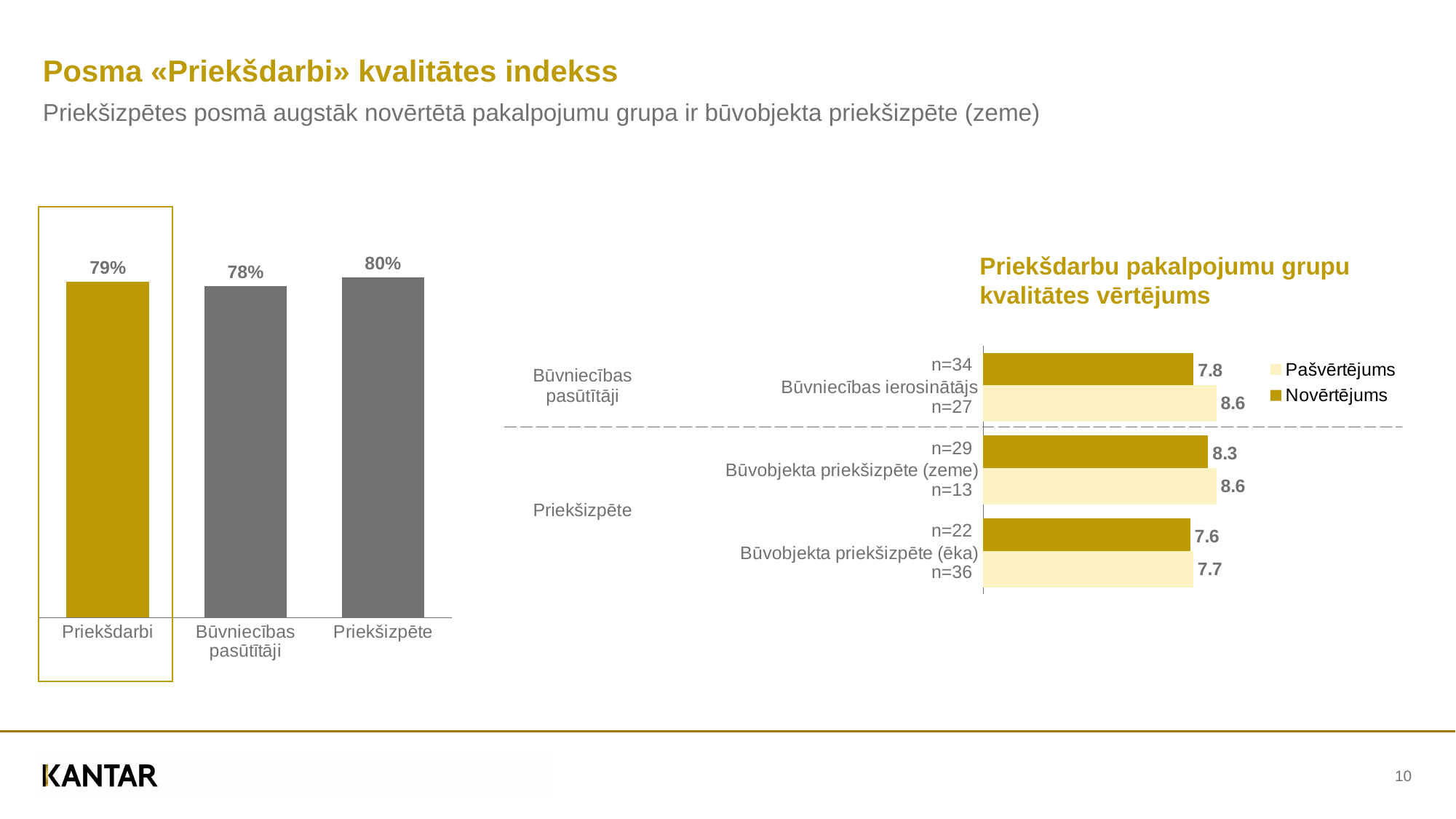
In the chart titled 'Priekšdarbu pakalpojumu grupu kvalitātes vērtējums', which is larger for Būvobjekta priekšizpēte (ēka): Pašvērtējums or Novērtējums? Pašvērtējums In the chart titled 'Priekšdarbu pakalpojumu grupu kvalitātes vērtējums', which category has the lowest Novērtējums value? Būvobjekta priekšizpēte (ēka) In the left bar chart, what is the difference between Priekšizpēte and Būvniecības pasūtītāji? 2% What type of chart is the chart titled 'Priekšdarbu pakalpojumu grupu kvalitātes vērtējums'? Bar chart In the left bar chart, which category has the lowest value? Būvniecības pasūtītāji How many series does the legend of the chart titled 'Priekšdarbu pakalpojumu grupu kvalitātes vērtējums' list? 2 In the left bar chart, which category has the highest value? Priekšizpēte In the chart titled 'Priekšdarbu pakalpojumu grupu kvalitātes vērtējums', what is the Pašvērtējums value for Būvniecības ierosinātājs? 8.6 In the chart titled 'Priekšdarbu pakalpojumu grupu kvalitātes vērtējums', what is the difference between the Pašvērtējums and Novērtējums values for Būvniecības ierosinātājs? 0.8 In the chart titled 'Priekšdarbu pakalpojumu grupu kvalitātes vērtējums', what is the Novērtējums value for Būvobjekta priekšizpēte (zeme)? 8.3 In the left bar chart, what is the value for Priekšdarbi? 79% In the left bar chart, how many categories are shown? 3